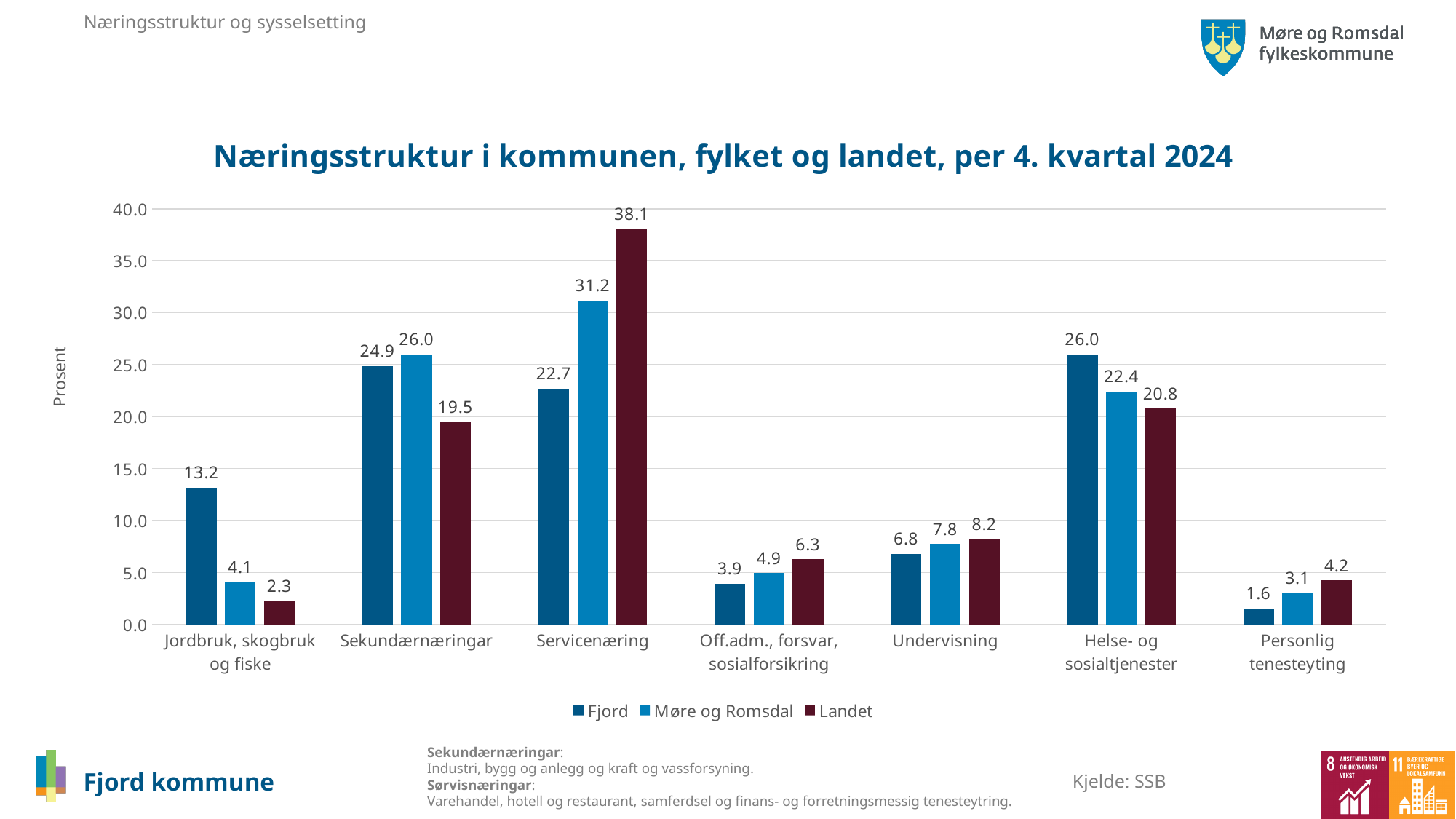
What kind of chart is shown on the slide? Bar chart Is the value for Landet in the Sekundærnæringar category greater or less than 20.0? less What is the value for Fjord in the Servicenæring category? 22.7 What is the value for Landet in the Jordbruk, skogbruk og fiske category? 2.3 How many series does the legend list? 3 Which category has the highest value for the Landet series? Servicenæring How many categories are shown on the x axis? 7 Which is larger in the Jordbruk, skogbruk og fiske category: the Fjord value or the Møre og Romsdal value? Fjord What is the difference between the Landet and Fjord values in the Servicenæring category? 15.4 Which category has the lowest value for the Fjord series? Personlig tenesteyting What is the label of the y axis? Prosent What is the value for Møre og Romsdal in the Helse- og sosialtjenester category? 22.4